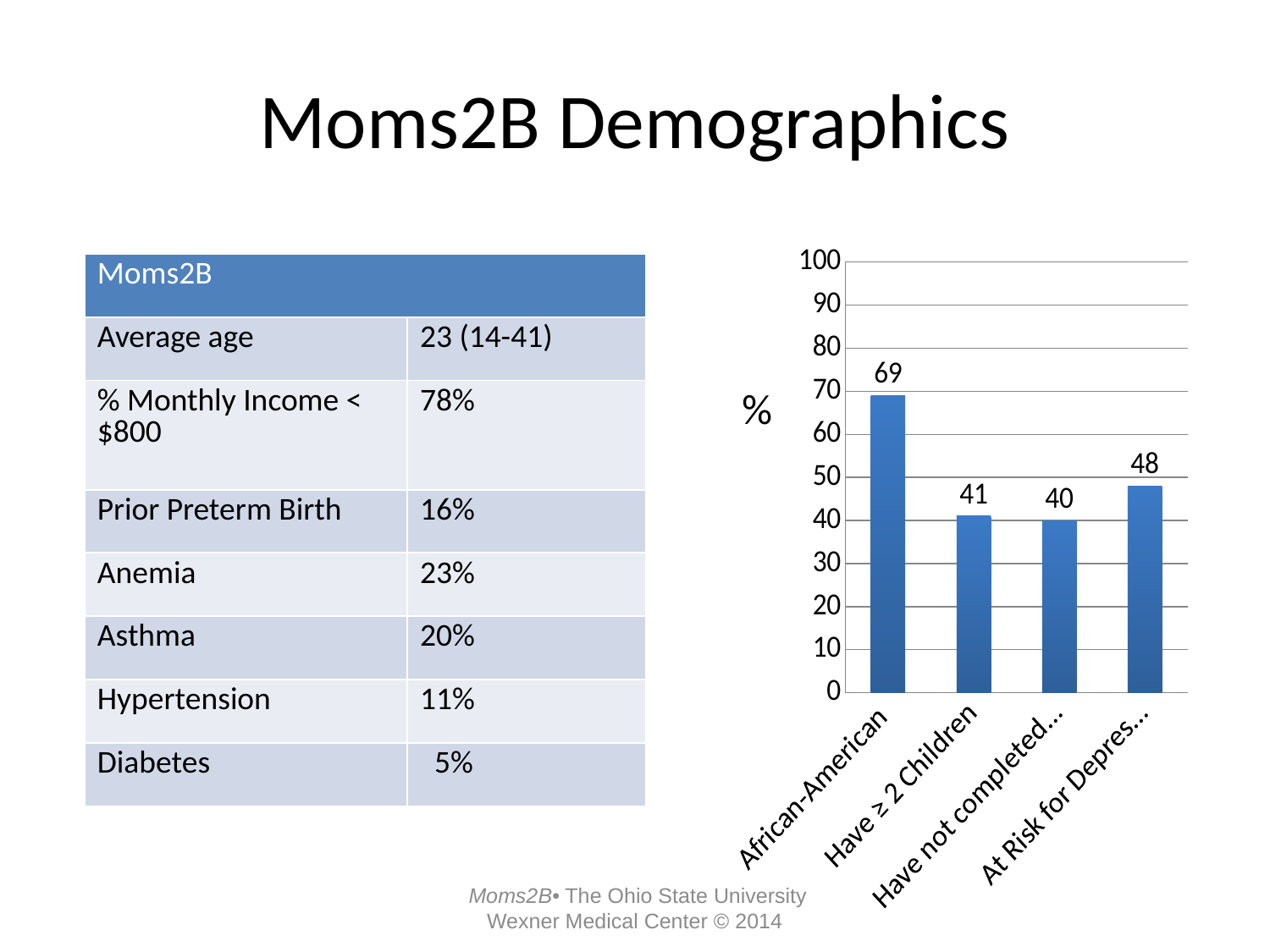
How many bars are shown in the chart? 4 Which category has the highest value in the bar chart? African-American What is the value for the 'At Risk for Depres...' bar in the chart? 48 What is the value for the 'Have not completed...' bar in the chart? 40 Which is larger in the chart: the value for 'Have ≥ 2 Children' or the value for 'At Risk for Depres...'? At Risk for Depres... Which category has the lowest value in the bar chart? Have not completed... What is the label on the vertical axis of the chart? % What kind of chart is shown on the slide? bar chart Is the value for African-American in the chart greater or less than 60? greater What is the value for the 'Have ≥ 2 Children' bar in the chart? 41 What is the difference between the African-American value and the 'At Risk for Depres...' value in the chart? 21 What is the value for African-American in the bar chart? 69